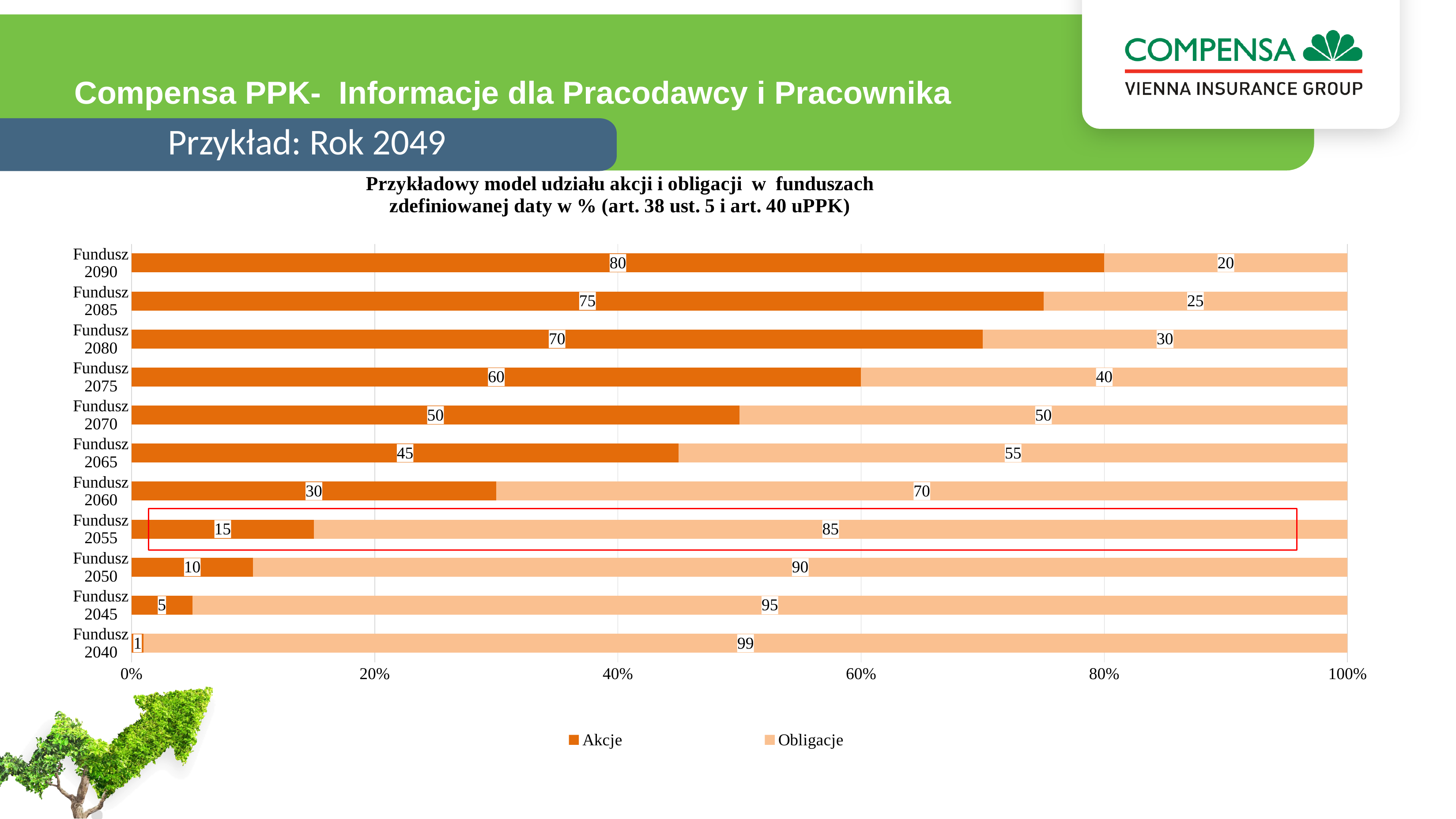
What is the Obligacje value for Fundusz 2080? 30 What kind of chart is shown on the slide? Stacked bar chart Which fund has the highest Akcje value? Fundusz 2090 Which fund's bar is highlighted with a red outline? Fundusz 2055 What is the difference between the Obligacje value for Fundusz 2050 and the Obligacje value for Fundusz 2060? 20 Which is larger: the Akcje value for Fundusz 2065 or the Akcje value for Fundusz 2075? Fundusz 2075 What is the Akcje value for Fundusz 2040? 1 What is the total of the stacked bar for Fundusz 2070? 100 How many series does the legend list? 2 How many funds are shown on the chart? 11 Which fund has the lowest Obligacje value? Fundusz 2090 What is the Akcje value for Fundusz 2055? 15